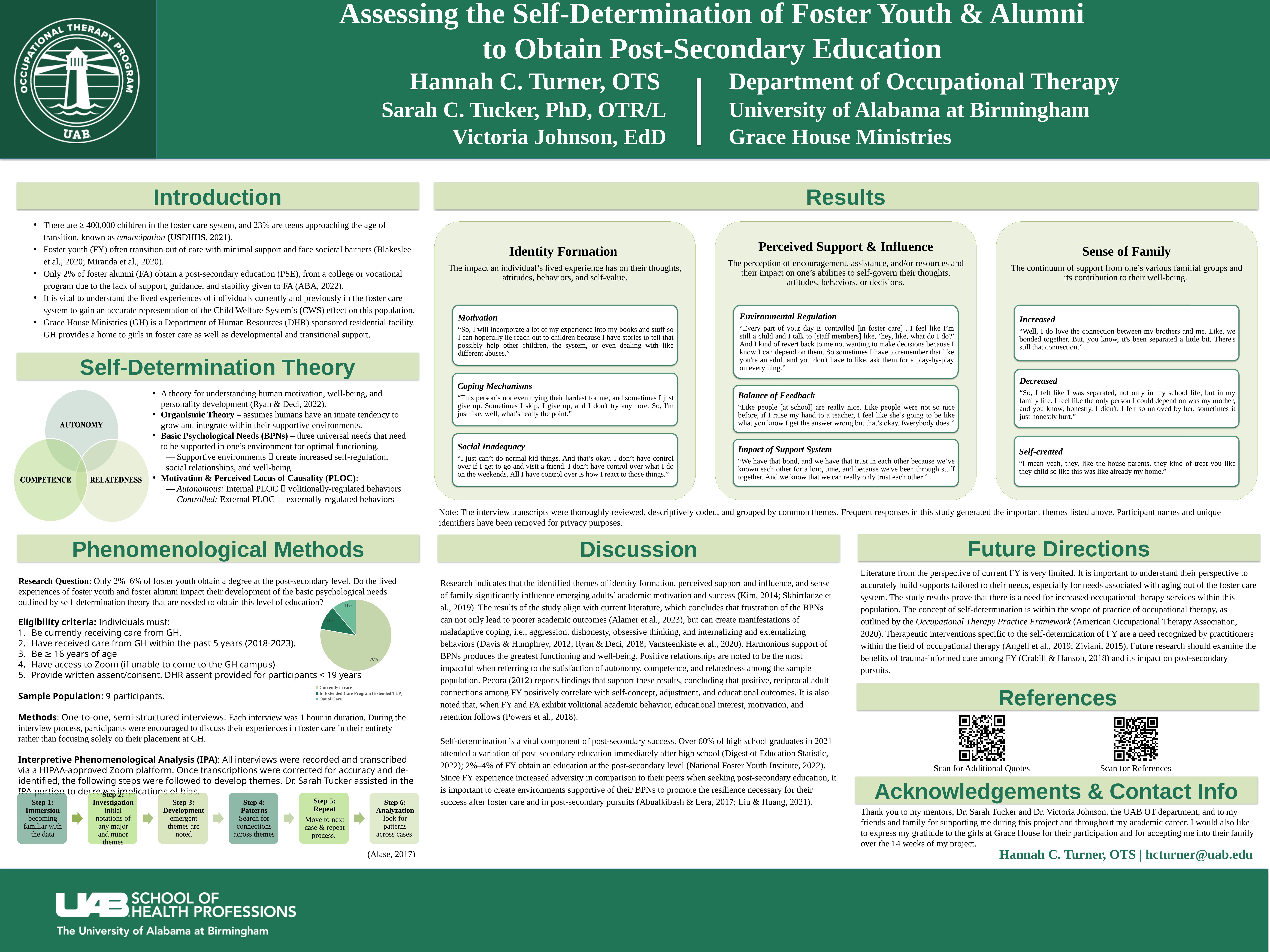
What are the three legend entries of the pie chart? Currently in care; In Extended Care Program (Extended TLP); Out of Care What is the difference between the 78% slice and the 11% slice in the pie chart? 67% Which legend entry in the pie chart refers to the Extended TLP? In Extended Care Program (Extended TLP) What share of the pie chart does the 'Currently in care' slice represent? 78% What is the value of the smallest labelled slice in the pie chart? 11% What kind of chart is shown in the Phenomenological Methods section? pie chart How many entries does the legend of the pie chart list? 3 How many slices does the pie chart in the Phenomenological Methods section have? 3 What is the value of the largest slice in the pie chart? 78% Is the largest slice of the pie chart greater or less than 50%? greater